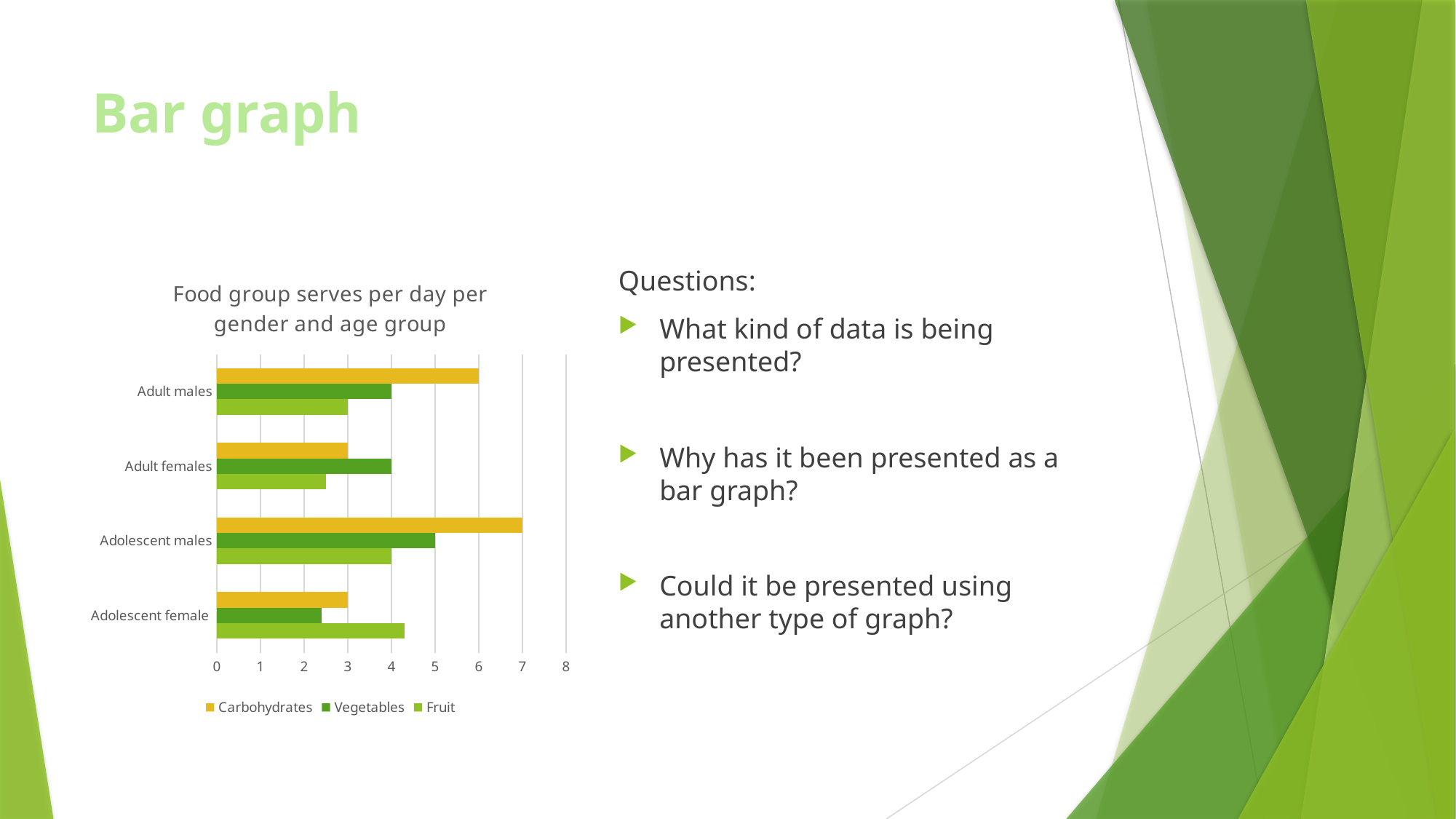
Is the Fruit value for Adult females greater or less than 3? less Which is larger: the Vegetables value for Adult males or the Vegetables value for Adolescent males? Adolescent males How many age/gender groups are shown on the chart? 4 What is the Carbohydrates value for Adult males? 6 What is the Carbohydrates value for Adolescent males? 7 What is the difference between the Carbohydrates values for Adolescent males and Adult males? 1 What is the Vegetables value for Adolescent males? 5 How many series does the legend list? 3 What kind of chart is shown on the slide? Bar chart Which group has the lowest Vegetables value? Adolescent female What is the title of the chart? Food group serves per day per gender and age group Which group has the highest Carbohydrates value? Adolescent males